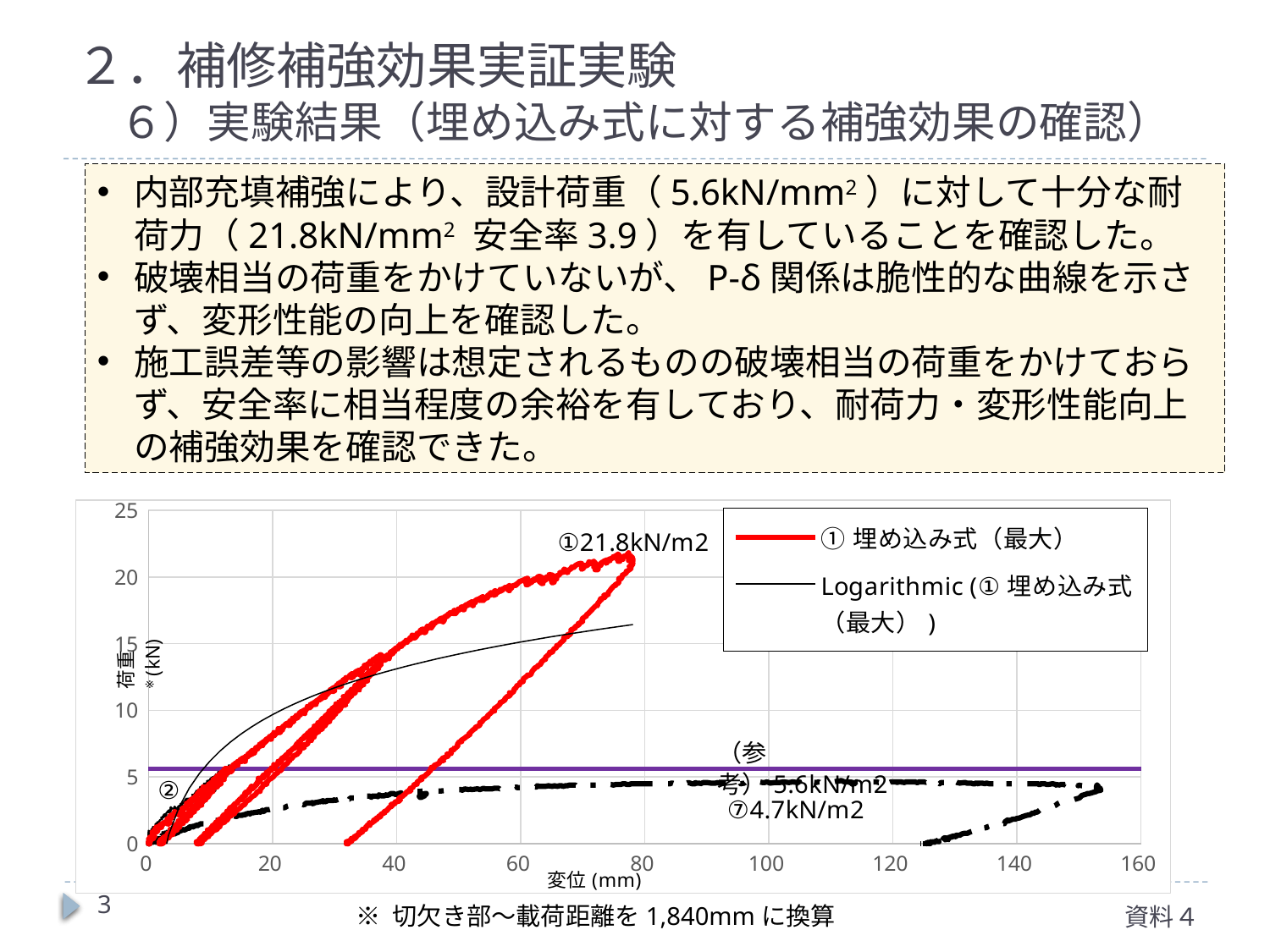
Is the peak load of the black dashed ⑦ curve greater or less than 5? less What is the label of the x axis of the chart? 変位 (mm) How many entries does the chart legend list? 2 What load value is labelled for ⑦ on the chart? 4.7kN/m2 Which reaches a higher load: series ① or series ⑦? ① What is the difference between the reference value 5.6kN/m2 and the ⑦ value 4.7kN/m2? 0.9kN/m2 What is the maximum load value labelled for series ① 埋め込み式（最大）? 21.8kN/m2 What colour is the line for ① 埋め込み式（最大） in the chart? red What kind of chart is shown on the slide? line chart Is the peak load of the red ① curve greater or less than 20? greater What value is labelled for the reference (参考) horizontal line on the chart? 5.6kN/m2 What is the difference between the labelled maximum of ① (21.8kN/m2) and the reference value 5.6kN/m2? 16.2kN/m2